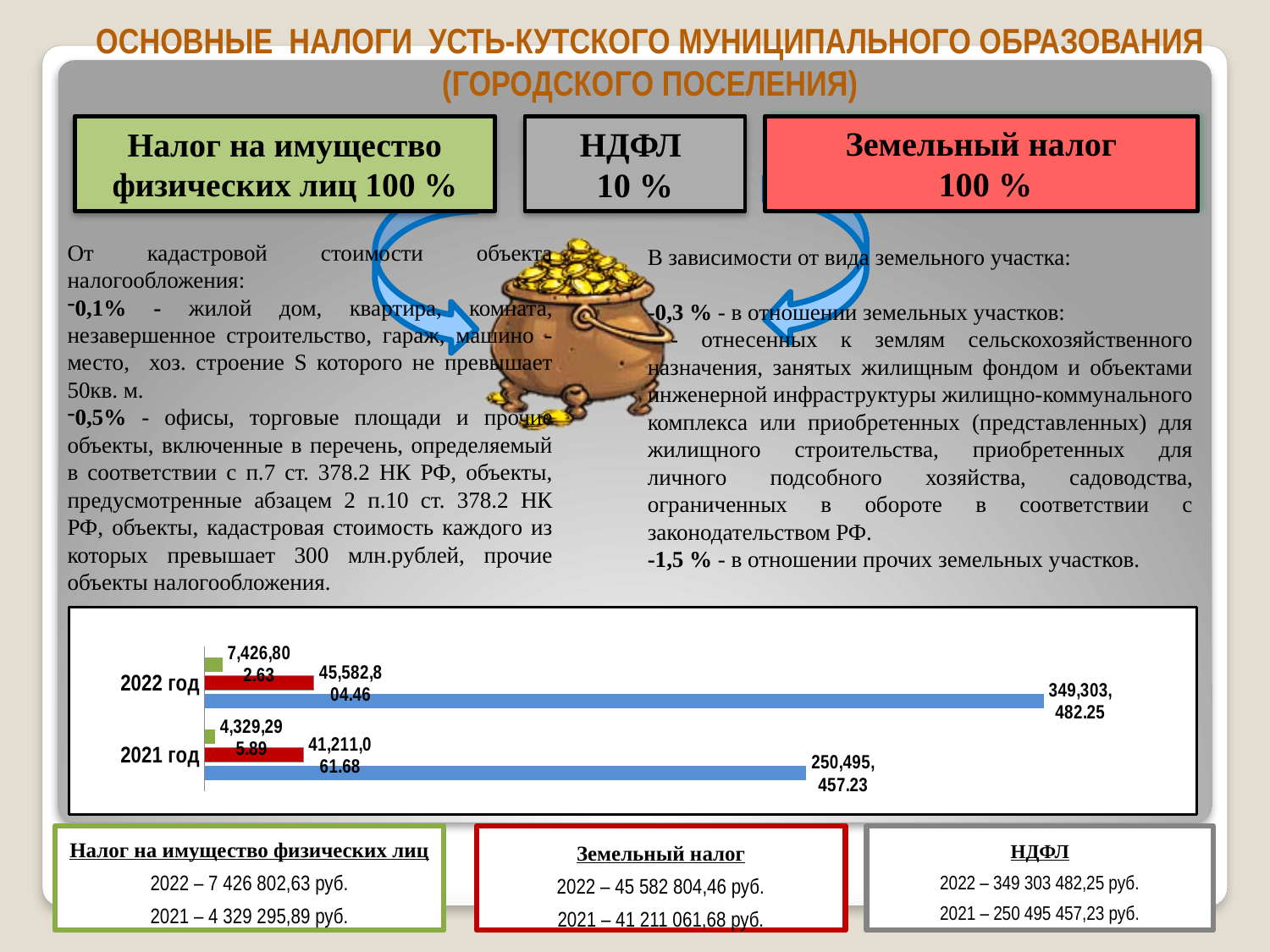
What is the value of the red bar for 2021 год? 41,211,061.68 Which year has the higher value for the blue bar? 2022 год What is the value of the green bar for 2021 год? 4,329,295.89 What is the difference between the green bar values for 2022 год and 2021 год? 3,097,506.74 What is the value of the longest (blue) bar for 2021 год? 250,495,457.23 By how much does the blue bar value for 2022 год exceed that for 2021 год? 98,808,025.02 Do the bar values rise or fall from 2021 год to 2022 год? rise How many bars are plotted for each year in the chart? 3 What is the value of the longest (blue) bar for 2022 год? 349,303,482.25 What kind of chart is shown on the slide? bar chart What is the difference between the red bar values for 2022 год and 2021 год? 4,371,742.78 How many year categories does the chart show? 2